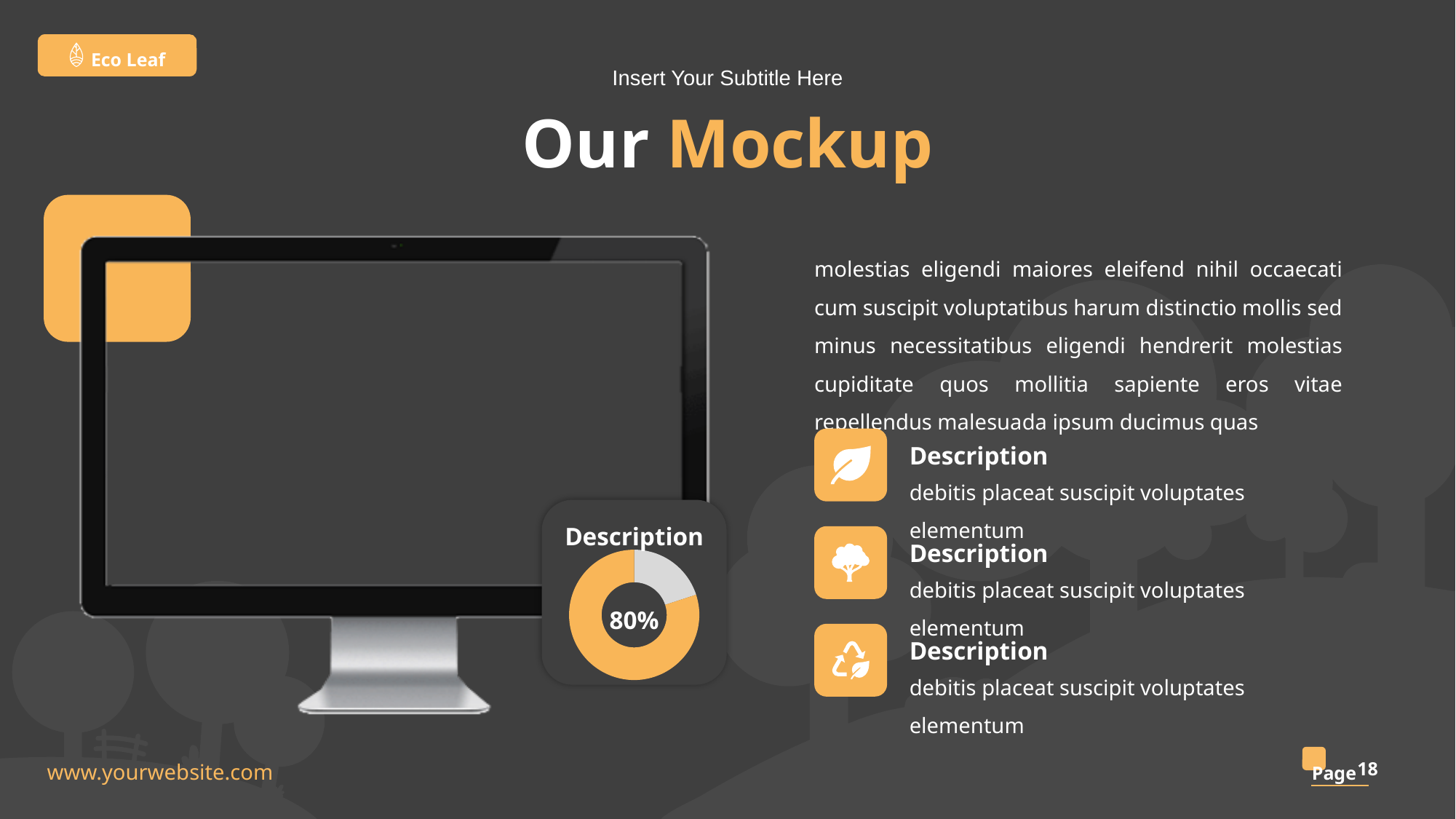
What colour is the larger segment of the donut chart? Orange What kind of chart is shown on the slide? Donut chart What share of the donut chart does the orange segment represent? 80% Which segment of the donut chart is larger, the orange one or the grey one? Orange Which segment of the donut chart is the smallest? Grey Is the value shown on the donut chart greater or less than 50%? greater What percentage is printed in the centre of the donut chart? 80% What is the title printed above the donut chart? Description How many segments does the donut chart have? 2